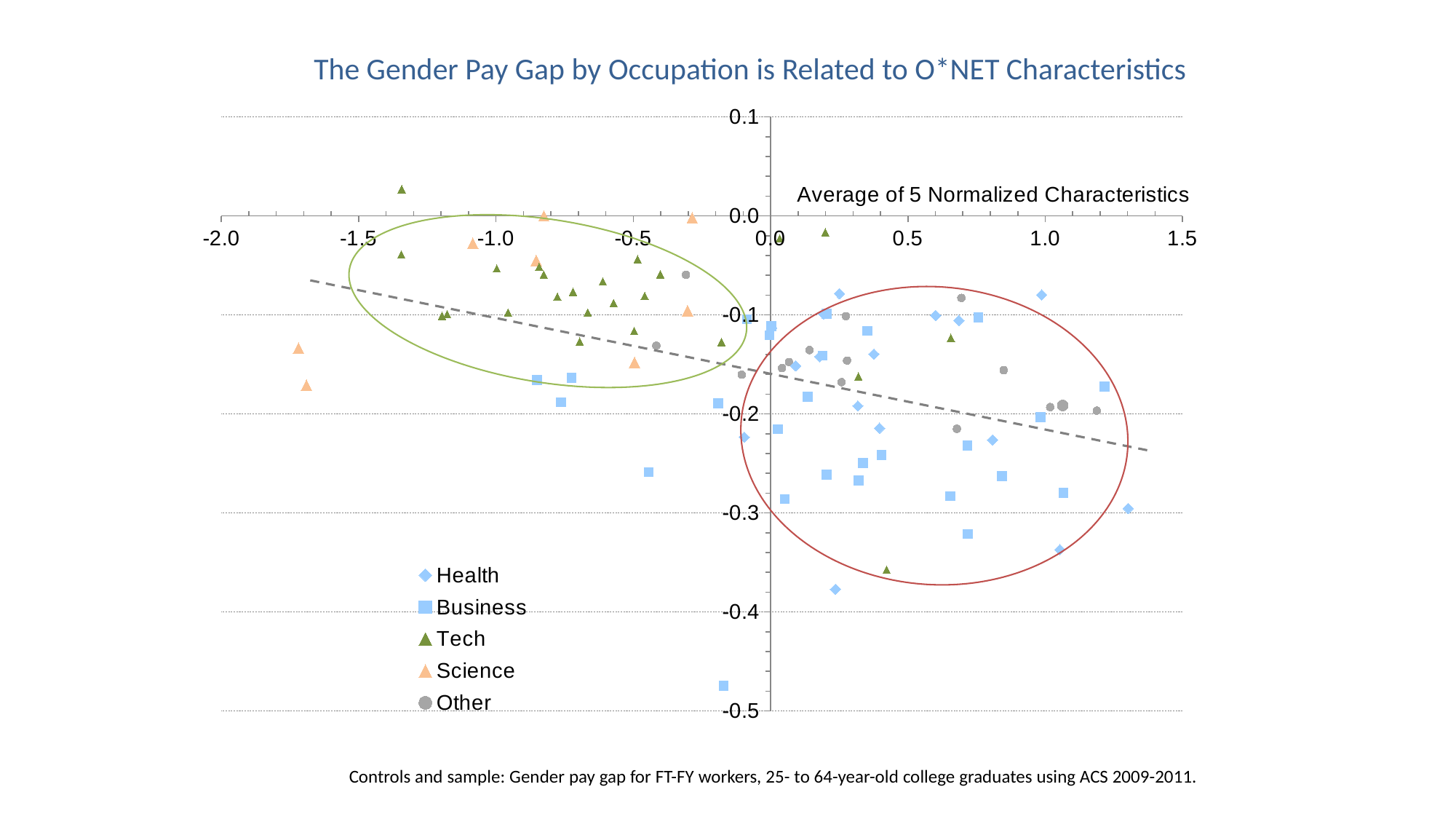
Which series is mostly enclosed by the green ellipse on the left side of the chart? Tech How many series does the legend list? 5 Is the highest point on the chart greater or less than 0.0? greater Which series does the highest point on the chart belong to? Tech Which series does the lowest point on the chart belong to? Business What is the title of the chart? The Gender Pay Gap by Occupation is Related to O*NET Characteristics What kind of chart is shown on the slide? scatter plot What is the maximum value shown on the vertical axis? 0.1 What is the label on the horizontal axis of the chart? Average of 5 Normalized Characteristics Is the lowest point on the chart greater or less than -0.4? less Which series do the two leftmost points on the chart (near x = -1.7) belong to? Science Does the dashed trend line rise or fall as the x-axis value increases? fall